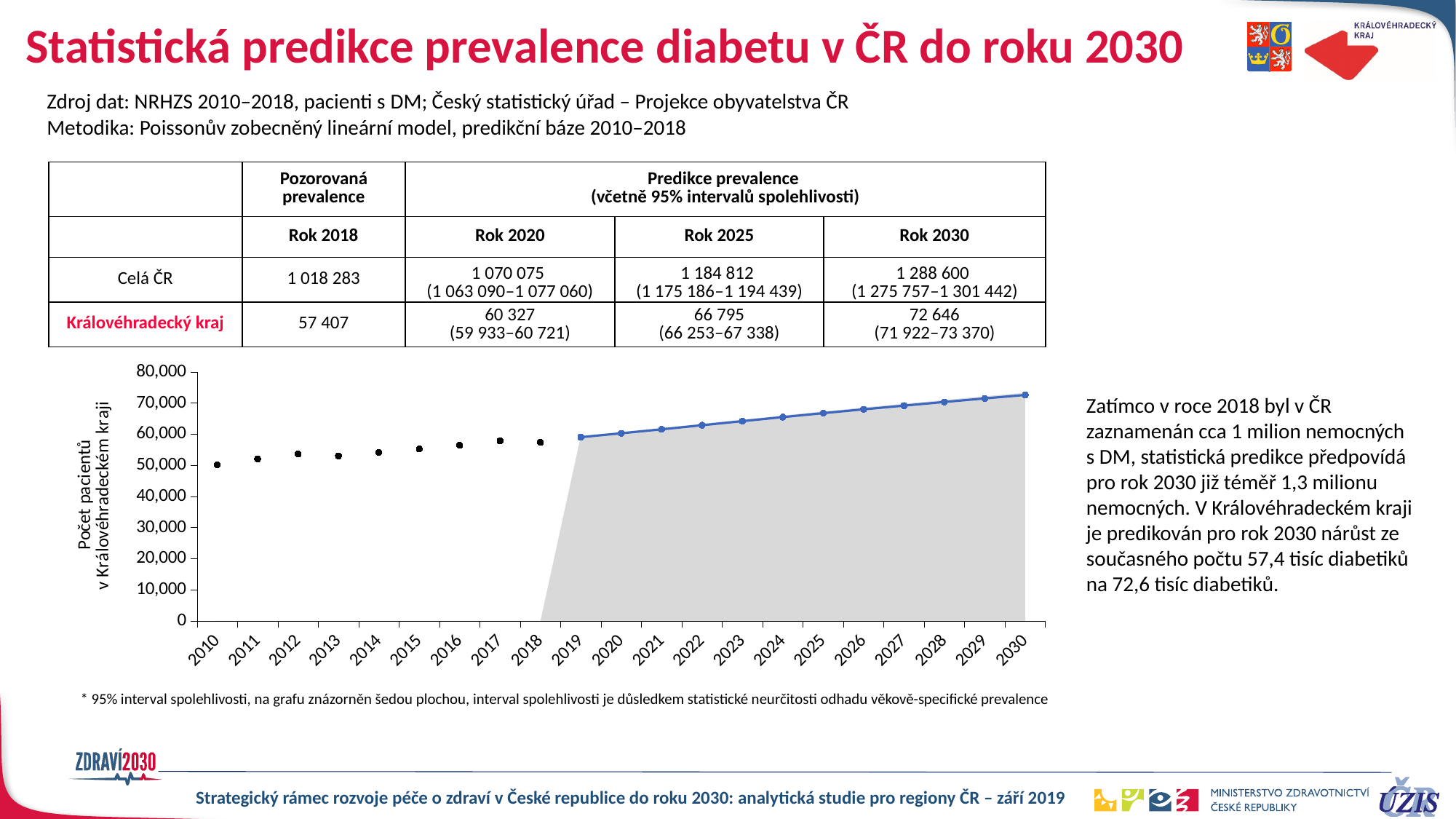
Is the plotted value for 2014 greater or less than 60,000? less What kind of chart is shown on the slide? line chart Is the plotted value for 2025 greater or less than 70,000? less Is the plotted value for 2012 greater or less than 50,000? greater Do the plotted values rise or fall from 2010 to 2030? rise How many years are shown on the x axis of the chart? 21 Which year has the highest plotted value in the chart? 2030 Which year has the lowest plotted value in the chart? 2010 According to the footnote, what does the grey area in the chart represent? 95% interval spolehlivosti What is the label of the y axis of the chart? Počet pacientů v Královéhradeckém kraji Is the plotted value for 2030 larger or smaller than the value for 2018? larger